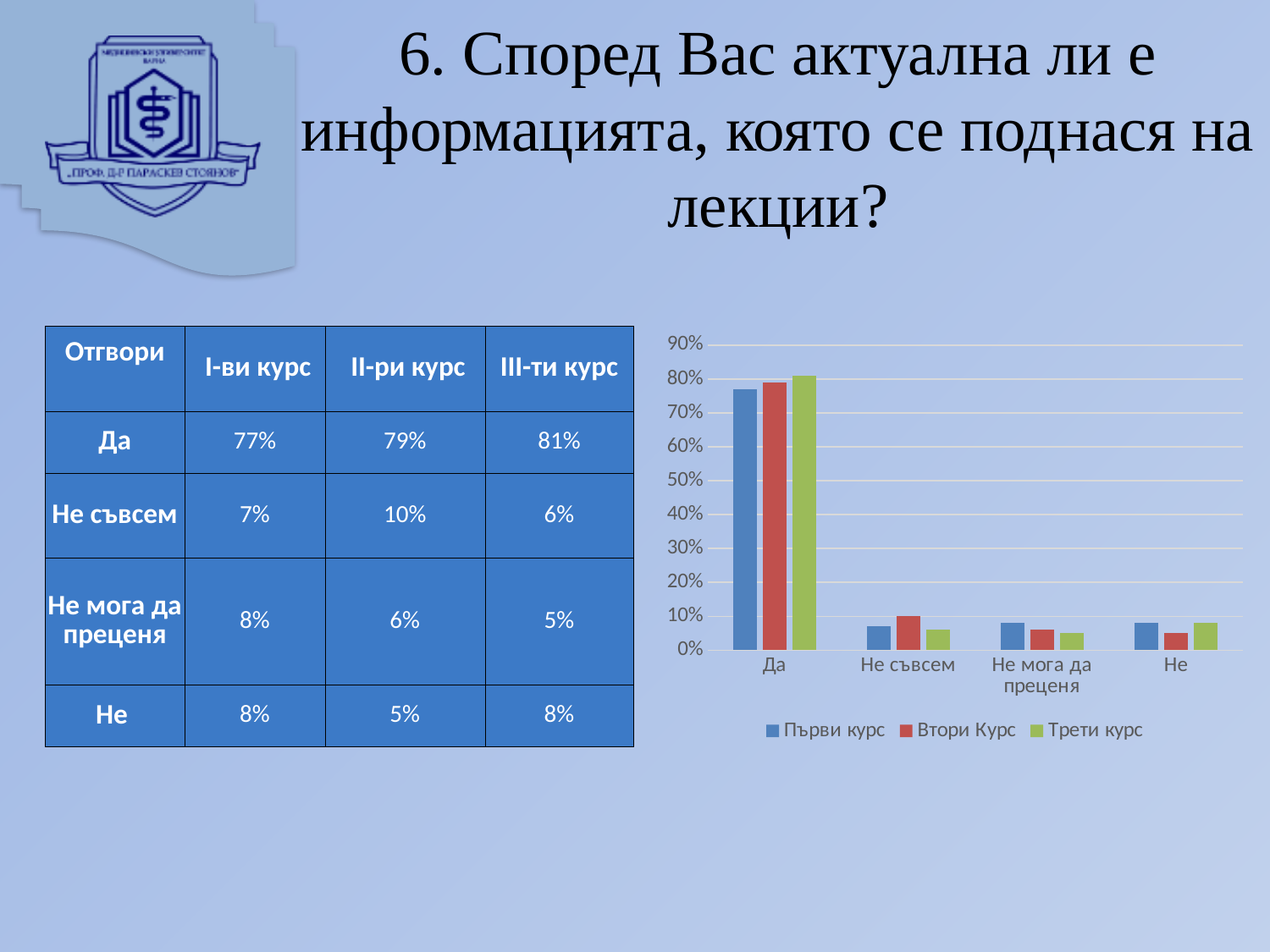
According to the slide, what is the value for Втори Курс (II-ри курс) in the category Не съвсем? 10% Is the value for Първи курс in the category Да greater or less than 70%? greater In the category Не съвсем, which series has the larger value: Втори Курс or Трети курс? Втори Курс How many categories are shown on the x axis of the chart? 4 What colour are the bars for the series Трети курс in the chart? green According to the slide, what is the value for Трети курс (III-ти курс) in the category Да? 81% According to the slide, what is the value for Първи курс (I-ви курс) in the category Не? 8% What kind of chart is shown on the slide? bar chart What is the difference between the Трети курс and Първи курс values in the category Да? 4% How many series does the chart legend list? 3 Is the value for Втори Курс in the category Не greater or less than 10%? less Which category has the highest values in the chart? Да